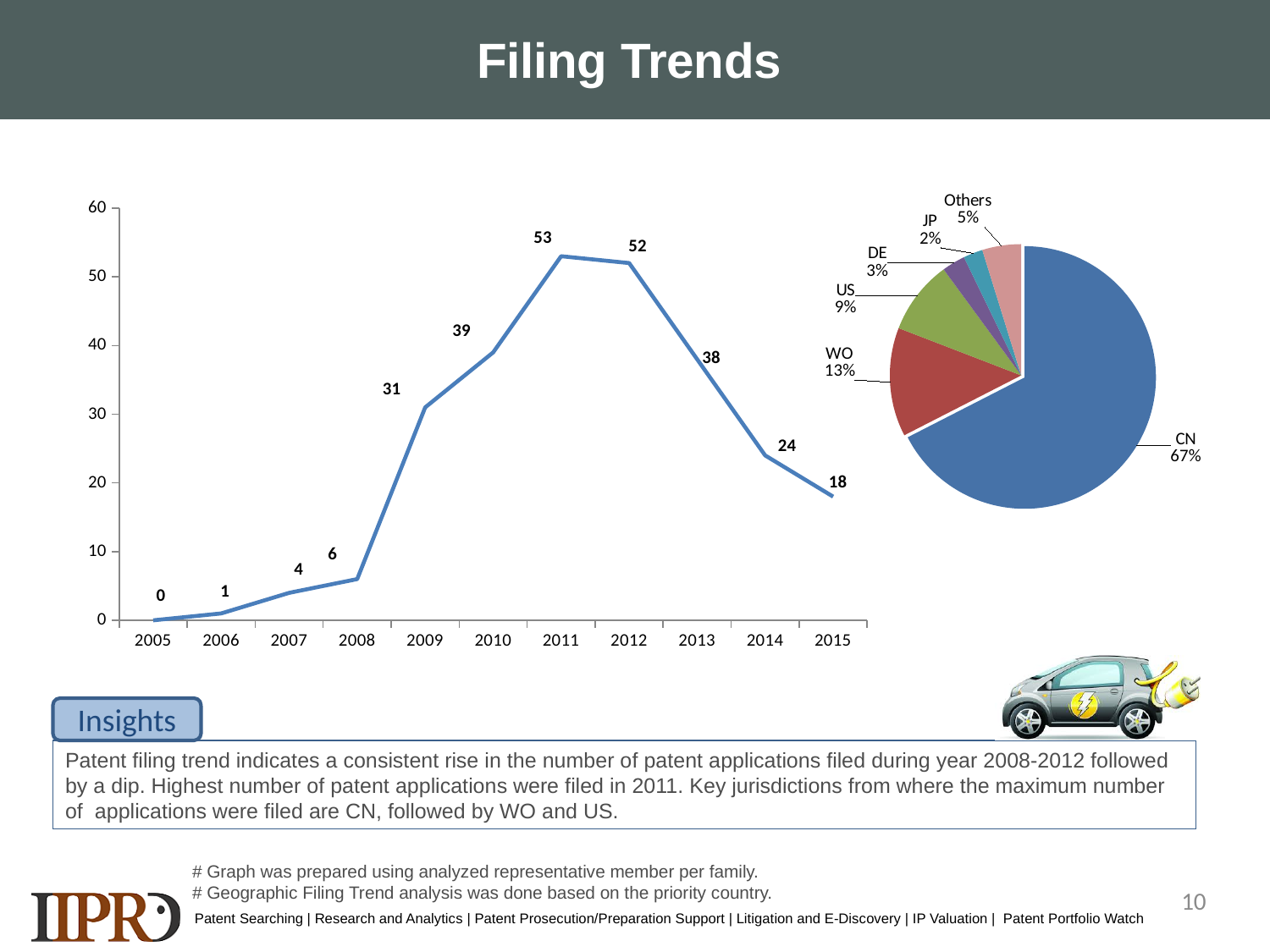
What kind of chart is the chart on the left? line chart In the line chart on the left, which year has the lowest value? 2005 In the line chart on the left, how many years are plotted on the x axis? 11 In the line chart on the left, what is the difference between the values for 2012 and 2013? 14 In the line chart on the left, do the values rise or fall from 2012 to 2015? fall In the line chart on the left, what is the value for 2009? 31 In the line chart on the left, which is larger, the value for 2010 or the value for 2013? 2010 In the pie chart on the right, what share does CN have? 67% In the pie chart on the right, how many slices are there? 6 In the line chart on the left, what is the value for 2011? 53 In the pie chart on the right, what share does WO have? 13% In the line chart on the left, which year has the highest value? 2011